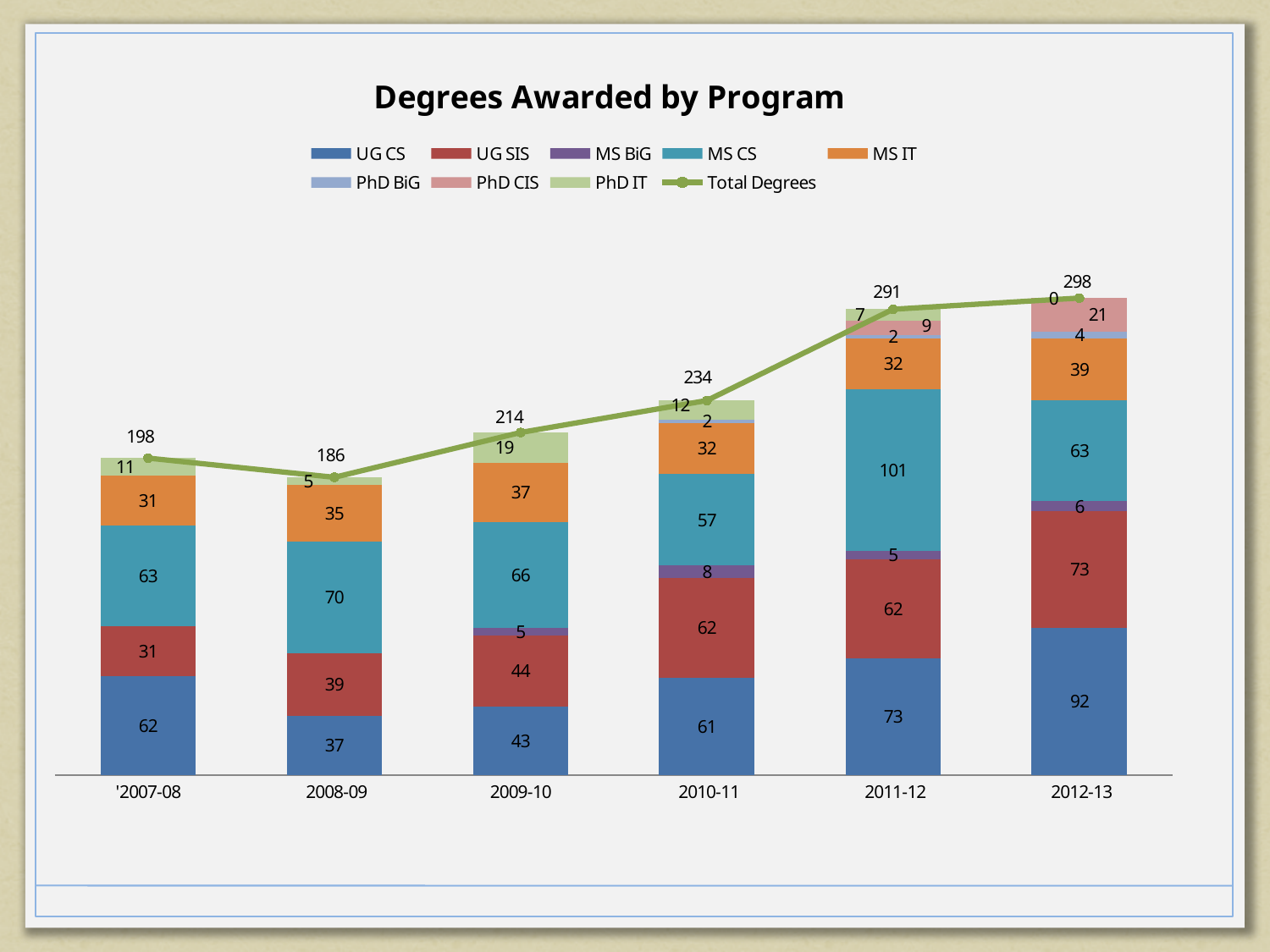
Which year has the highest Total Degrees value? 2012-13 How many years are shown on the x axis? 6 What is the difference between the Total Degrees values for 2011-12 and 2010-11? 57 How many UG CS degrees were awarded in 2011-12? 73 How many series does the legend list? 9 What kind of chart is this? Stacked bar chart with a line What is the MS CS value for 2008-09? 70 What is the title of the chart? Degrees Awarded by Program What is the Total Degrees value for 2012-13? 298 Which is larger, the MS CS value for 2011-12 or the MS CS value for 2012-13? 2011-12 What is the MS IT value for 2009-10? 37 Which year has the lowest Total Degrees value? 2008-09